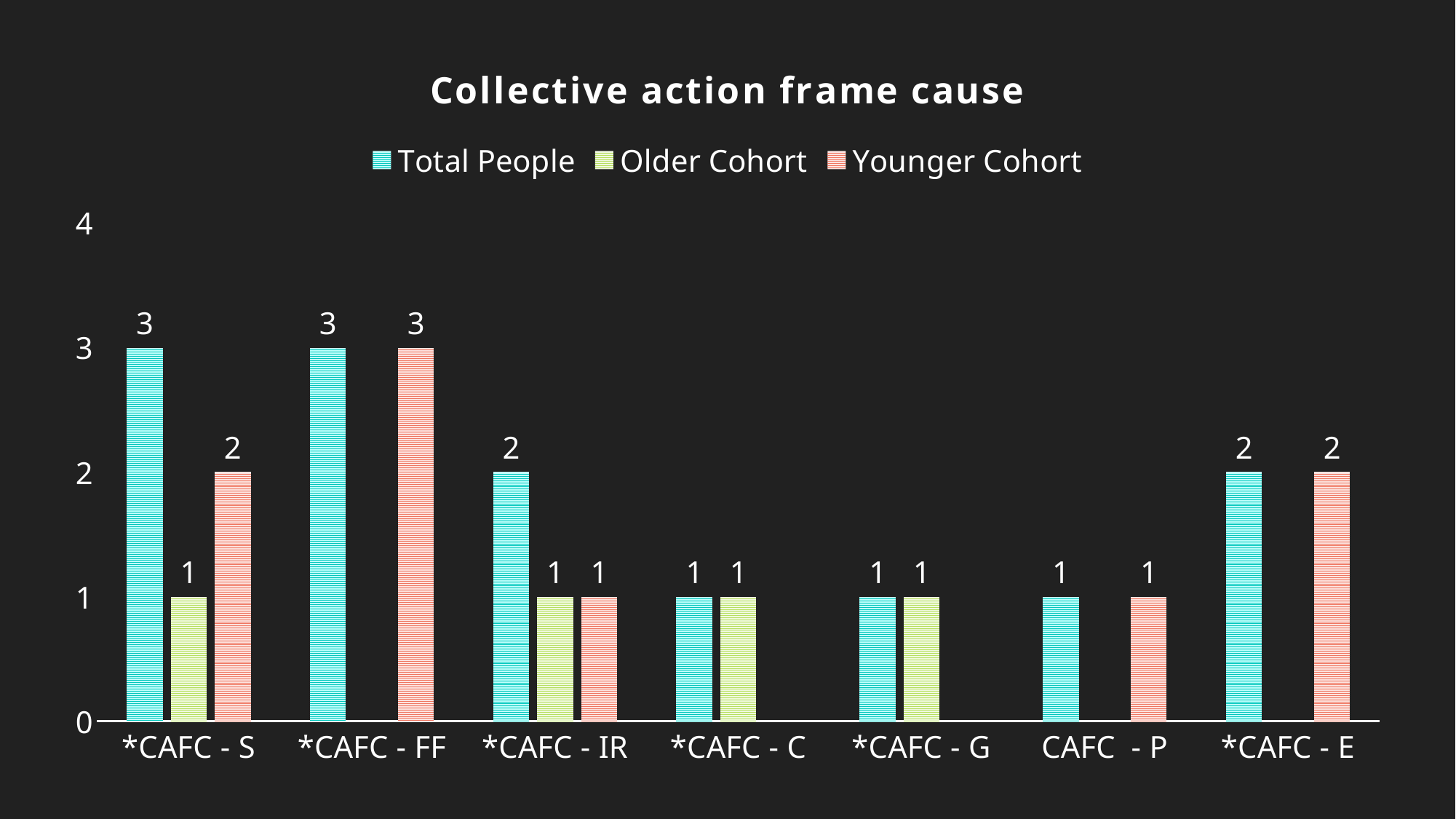
What kind of chart is this? Bar chart What is the title of the chart? Collective action frame cause What is the Total People value for *CAFC - S? 3 How many series does the legend list? 3 What is the Older Cohort value for *CAFC - IR? 1 What is the difference between the Total People value and the Older Cohort value for *CAFC - S? 2 What is the Total People value for CAFC - P? 1 Which category has the highest Younger Cohort value? *CAFC - FF How many categories are shown on the x axis? 7 Which is larger for *CAFC - S: the Younger Cohort value or the Older Cohort value? Younger Cohort What is the Younger Cohort value for *CAFC - E? 2 What is the Younger Cohort value for *CAFC - FF? 3